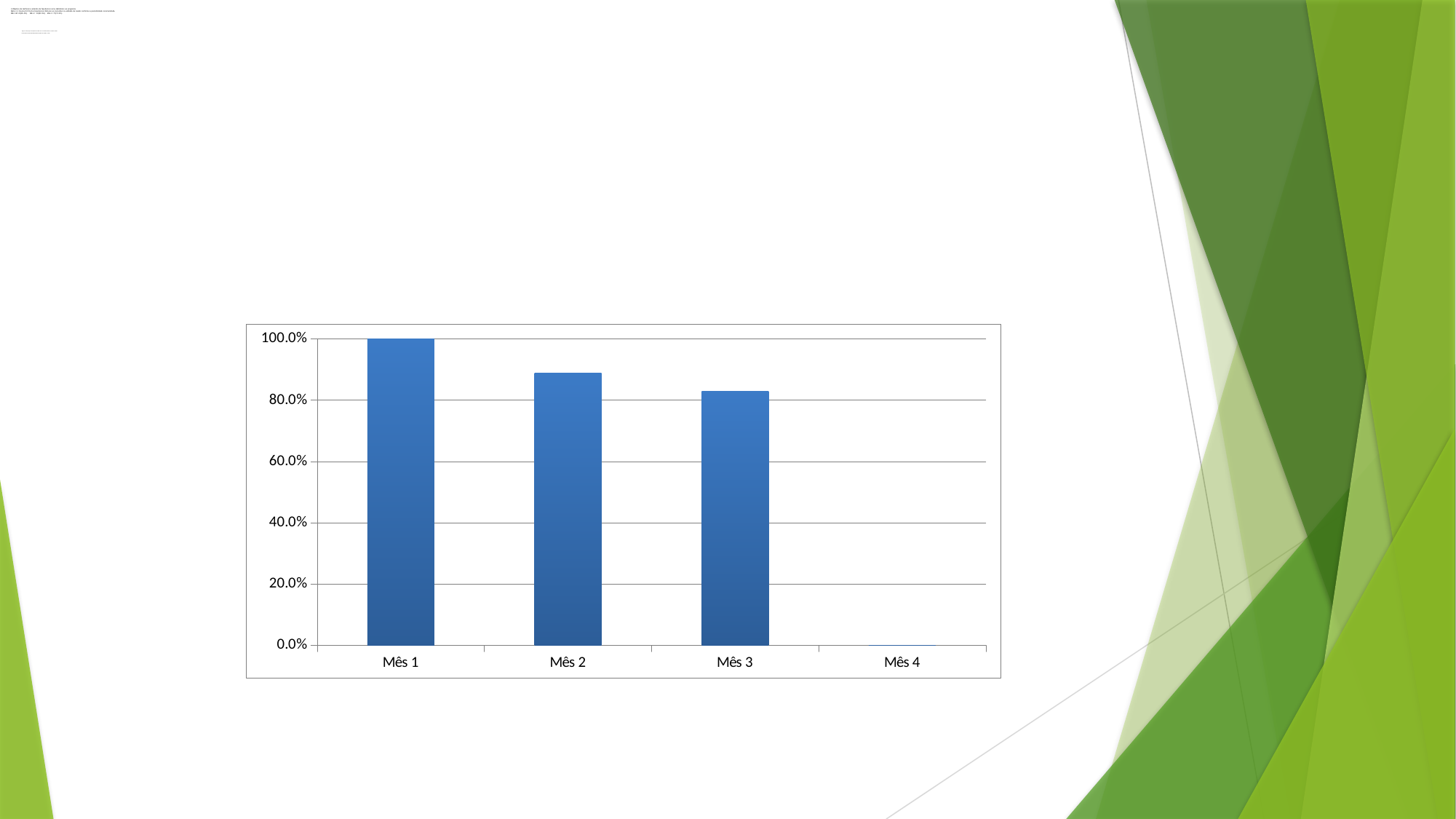
What kind of chart is shown on the slide? bar chart Is the value for Mês 4 greater or less than 20.0%? less What is the highest value shown on the y axis of the chart? 100.0% How many categories are shown on the x axis of the chart? 4 What colour are the bars in the chart? blue Which is larger, the value for Mês 2 or the value for Mês 3? Mês 2 What is the value for Mês 1? 100.0% Is the value for Mês 3 greater or less than 60.0%? greater Do the values rise or fall from Mês 1 to Mês 4? fall Is the value for Mês 2 greater or less than 80.0%? greater Which category has the highest value in the chart? Mês 1 Which category has the lowest value in the chart? Mês 4